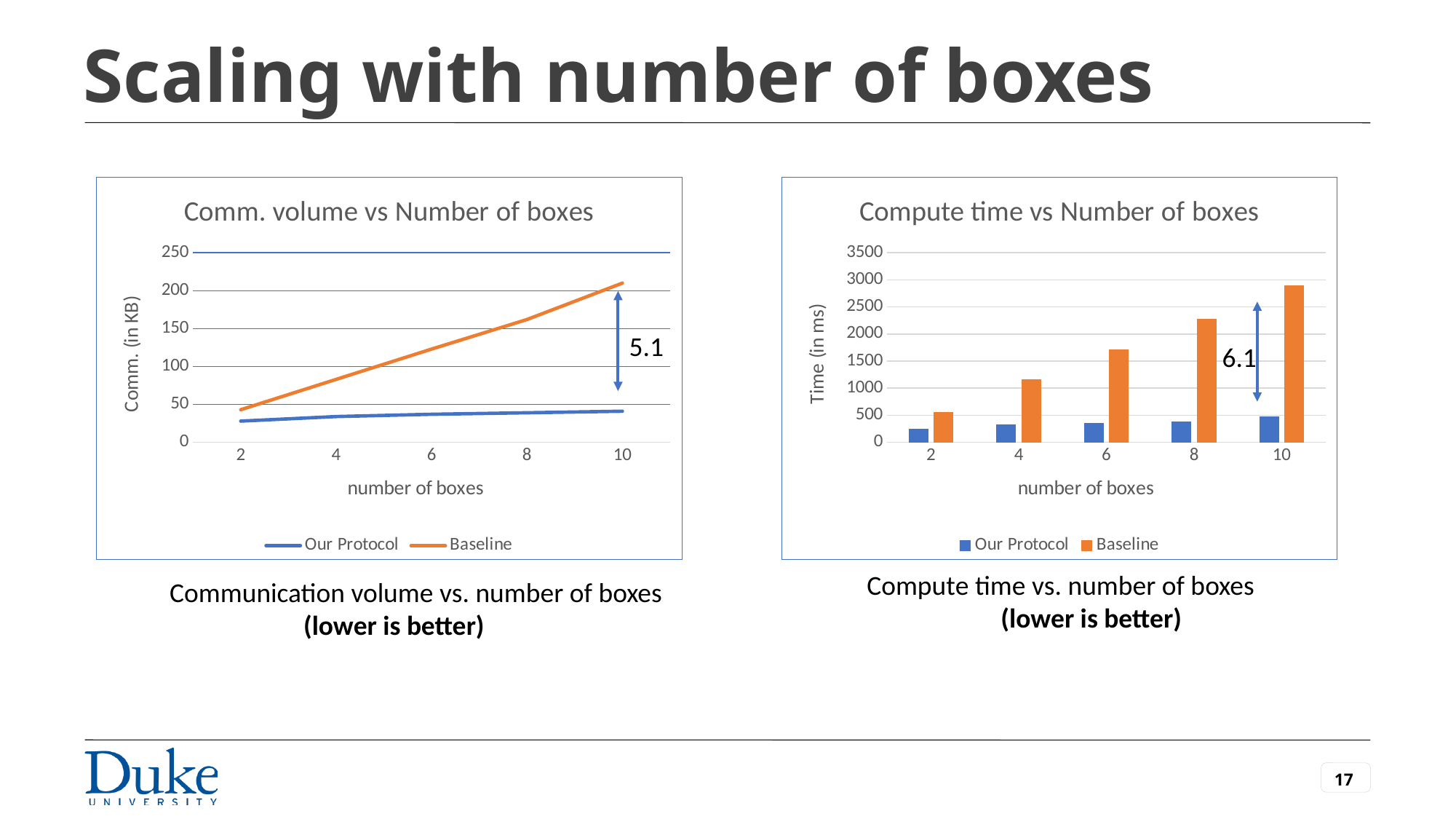
In the 'Compute time vs Number of boxes' chart, at which number of boxes is the Baseline bar highest? 10 In the 'Comm. volume vs Number of boxes' chart, is the Baseline value at 10 boxes greater or less than 200? greater In the 'Compute time vs Number of boxes' chart, what is the label of the y axis? Time (in ms) In the 'Compute time vs Number of boxes' chart, is the Our Protocol value at 10 boxes greater or less than 1000? less In the 'Compute time vs Number of boxes' chart, how many number-of-boxes categories are shown on the x axis? 5 What kind of chart is the 'Comm. volume vs Number of boxes' chart? line chart In the 'Comm. volume vs Number of boxes' chart, how many series does the legend list? 2 In the 'Compute time vs Number of boxes' chart, is the Baseline value at 10 boxes greater or less than 2500? greater What kind of chart is the 'Compute time vs Number of boxes' chart? bar chart In the 'Comm. volume vs Number of boxes' chart, does the Baseline line rise or fall as the number of boxes increases? rise In the 'Comm. volume vs Number of boxes' chart, which series has the higher value at 10 boxes, Our Protocol or Baseline? Baseline